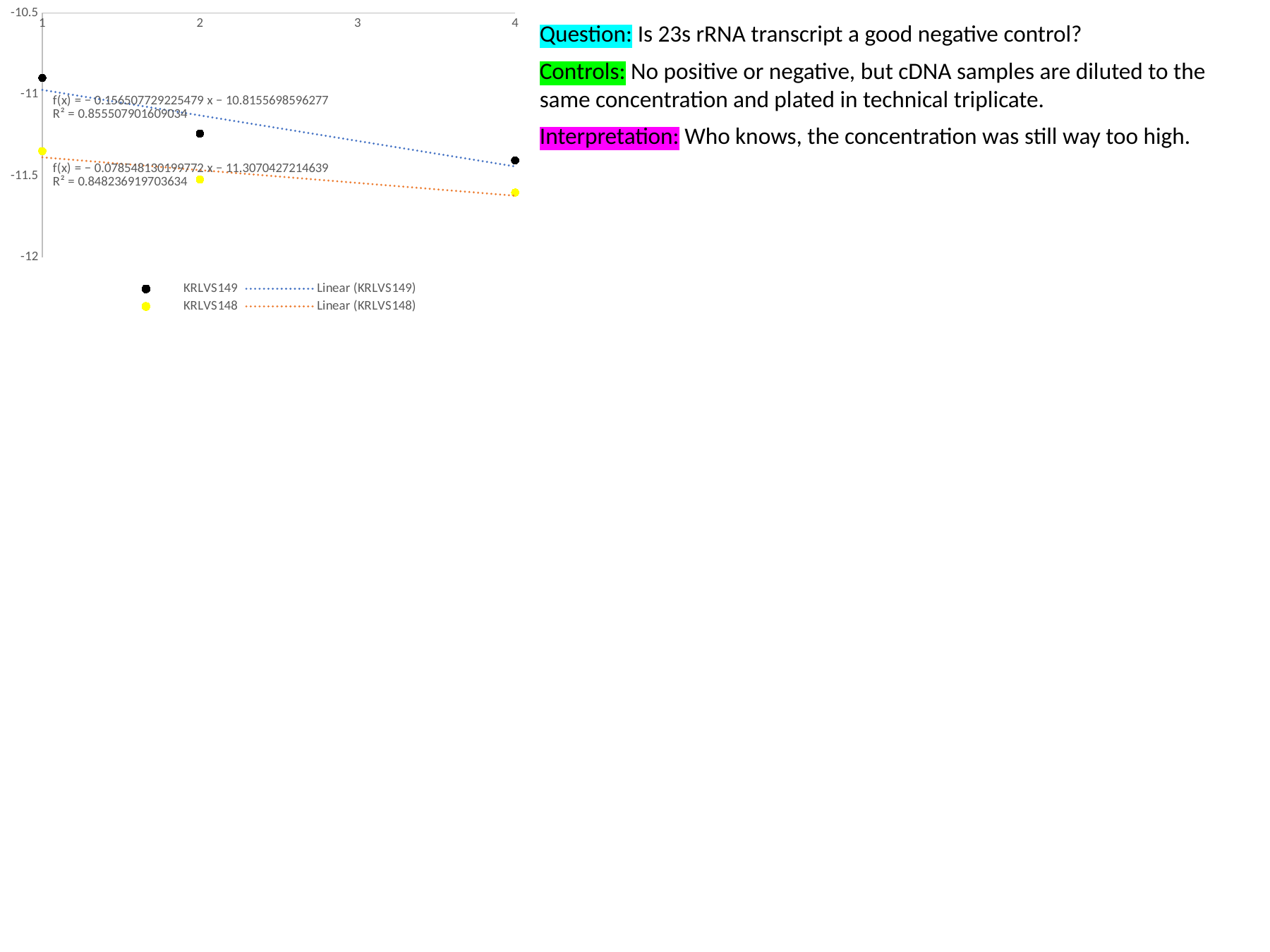
At x = 1, which series has the higher value, KRLVS149 or KRLVS148? KRLVS149 Is the KRLVS149 value at x = 1 greater or less than -11? greater What kind of chart is shown on the slide? scatter chart How many entries does the chart legend list? 4 Do the KRLVS148 values rise or fall as x increases from 1 to 4? fall Is the KRLVS149 value at x = 4 greater or less than -11.5? greater How many data points are plotted for the KRLVS149 series? 3 Do the KRLVS149 values rise or fall as x increases from 1 to 4? fall Is the KRLVS148 value at x = 4 greater or less than -11.5? less What colour are the markers for the KRLVS148 series? yellow What is the R² value shown for the KRLVS148 linear trendline? 0.848236919703634 What is the R² value shown for the KRLVS149 linear trendline? 0.855507901609034